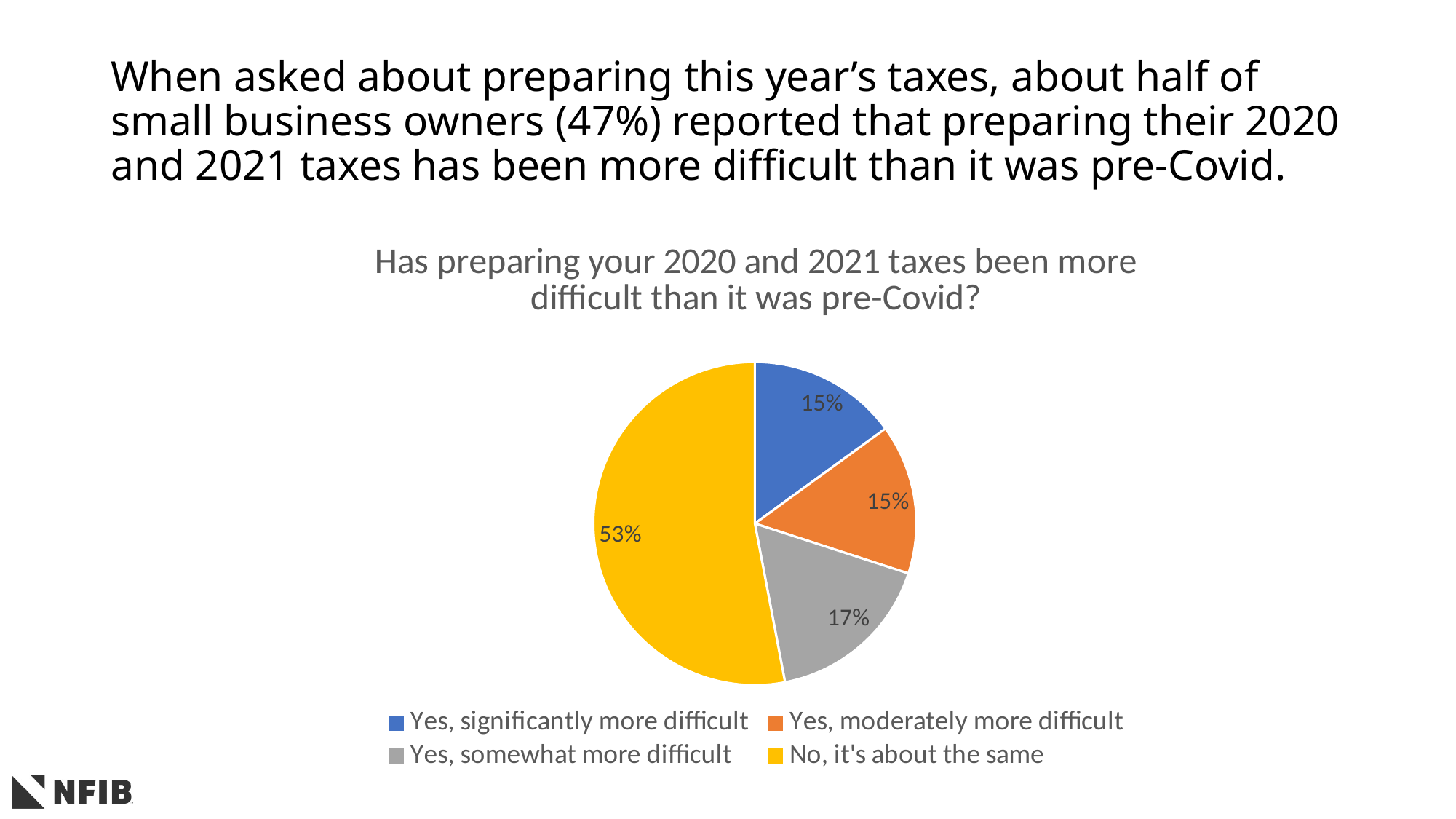
What share of respondents answered "No, it's about the same"? 53% Which is larger: the share for "Yes, somewhat more difficult" or the share for "Yes, significantly more difficult"? Yes, somewhat more difficult How many entries does the legend list? 4 What colour is the slice for "No, it's about the same"? yellow Which response has the largest slice of the pie? No, it's about the same What is the difference between the share for "No, it's about the same" and the share for "Yes, somewhat more difficult"? 36% How many slices does the pie chart have? 4 What kind of chart is shown on the slide? pie chart What share of respondents answered "Yes, moderately more difficult"? 15% What is the title of the pie chart? Has preparing your 2020 and 2021 taxes been more difficult than it was pre-Covid? What share of respondents answered "Yes, significantly more difficult"? 15% What share of respondents answered "Yes, somewhat more difficult"? 17%